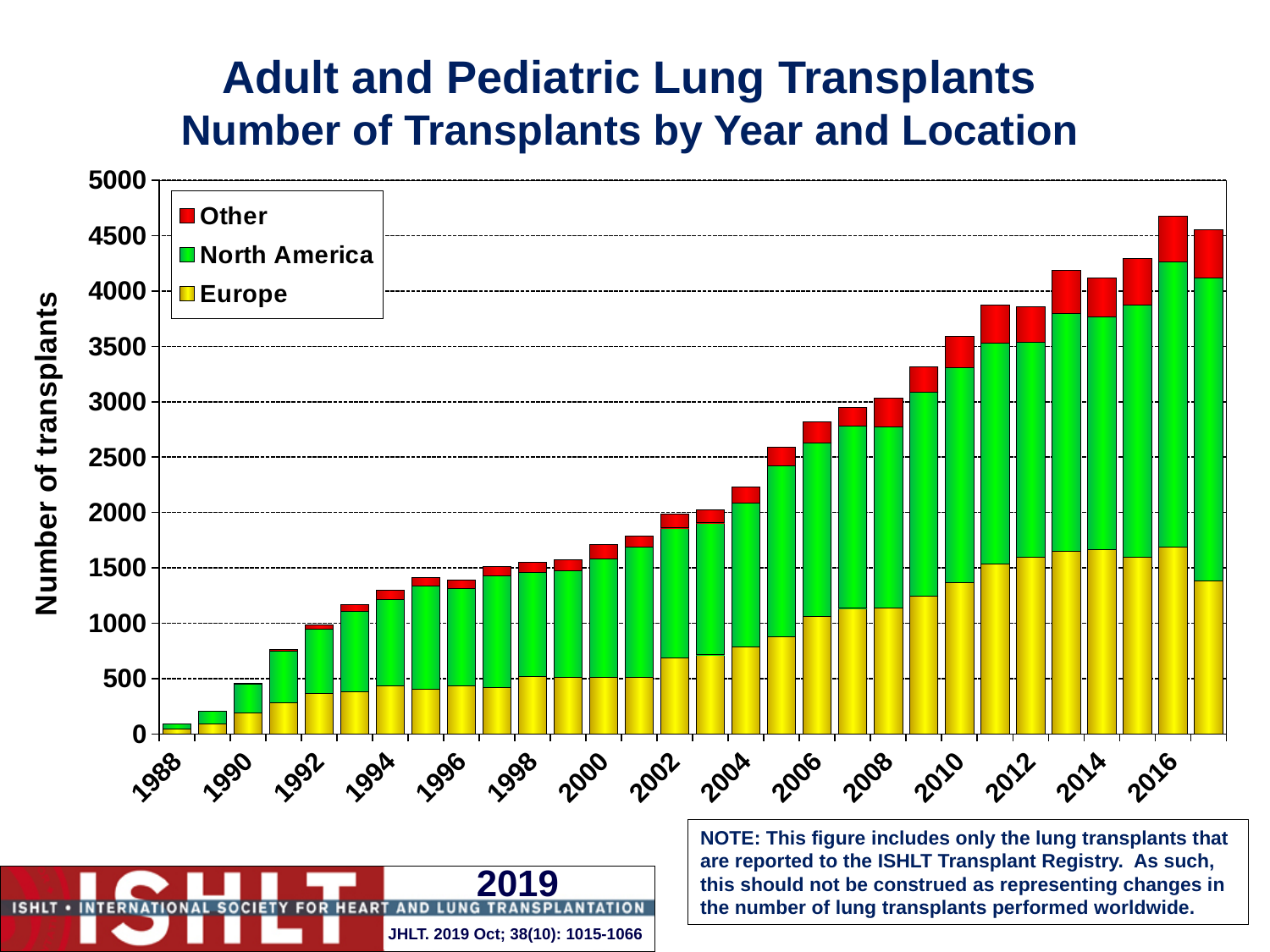
How many series does the legend list? 3 Which year has the tallest bar (highest total number of transplants)? 2016 What kind of chart is shown on the slide? Stacked bar chart Overall, do the total number of transplants rise or fall from 1988 to 2016? rise Which year has the shortest bar (lowest total number of transplants)? 1988 Which colour represents Europe in the chart? Yellow What is the label on the vertical axis? Number of transplants Is the total number of transplants for 2016 greater or less than 4500? greater Is the total number of transplants for 2006 greater or less than 3000? less Is the total number of transplants for 2000 greater or less than 1500? greater Which year has the larger total number of transplants, 2004 or 2008? 2008